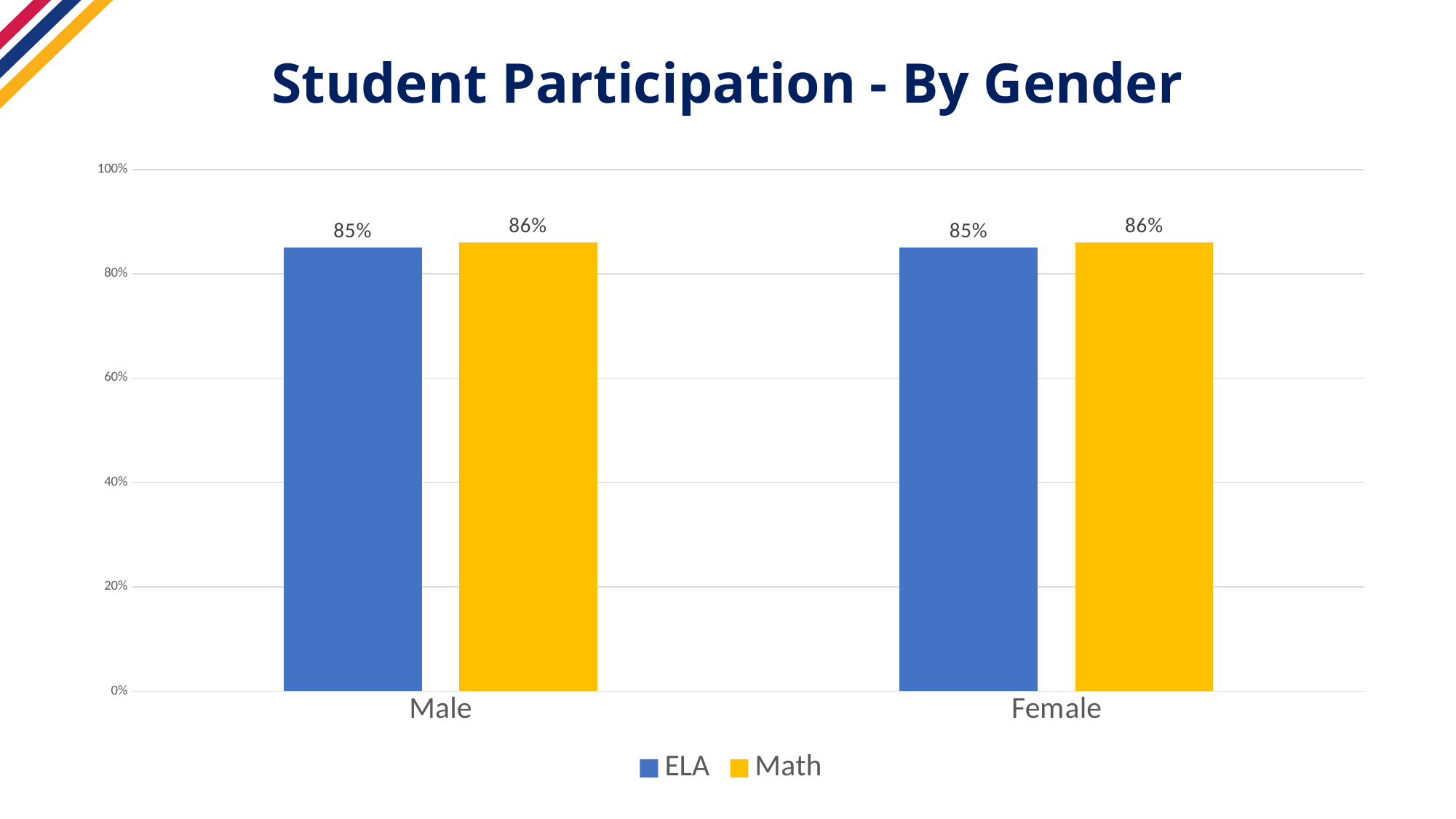
What is the difference between the Math and ELA participation rates for Female students? 1% What is the ELA participation rate for Female students? 85% How many gender categories are shown on the x axis? 2 What kind of chart is shown on the slide? Bar chart What is the title of the chart? Student Participation - By Gender What is the Math participation rate for Female students? 86% Is the Math participation rate for Male students greater or less than 100%? less What is the Math participation rate for Male students? 86% How many series does the legend list? 2 Is the ELA participation rate for Female students greater or less than 80%? greater What is the difference between the Math and ELA participation rates for Male students? 1% What is the ELA participation rate for Male students? 85%